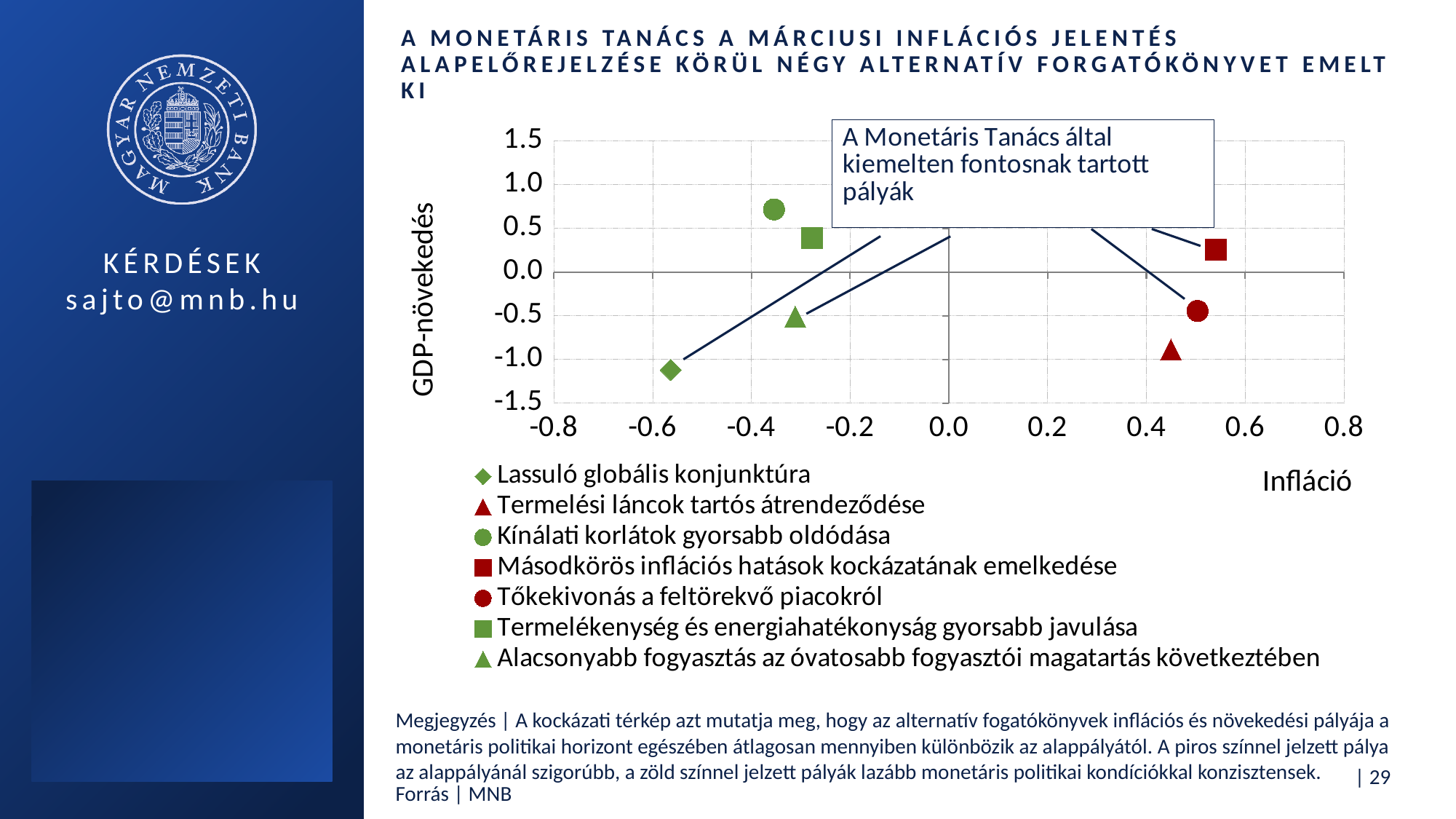
Is the GDP-növekedés value for Lassuló globális konjunktúra greater or less than -1.0? less Which has the larger GDP-növekedés value: Termelékenység és energiahatékonyság gyorsabb javulása or Alacsonyabb fogyasztás az óvatosabb fogyasztói magatartás következtében? Termelékenység és energiahatékonyság gyorsabb javulása Which series has the highest GDP-növekedés value? Kínálati korlátok gyorsabb oldódása How many series does the legend list? 7 Is the GDP-növekedés value for Termelési láncok tartós átrendeződése greater or less than -0.5? less What is the title of the horizontal axis? Infláció Is the GDP-növekedés value for Kínálati korlátok gyorsabb oldódása greater or less than 0.5? greater How many data points are plotted on the chart? 7 Which series has the lowest Infláció value? Lassuló globális konjunktúra What kind of chart is shown on the slide? Scatter chart What is the title of the vertical axis? GDP-növekedés